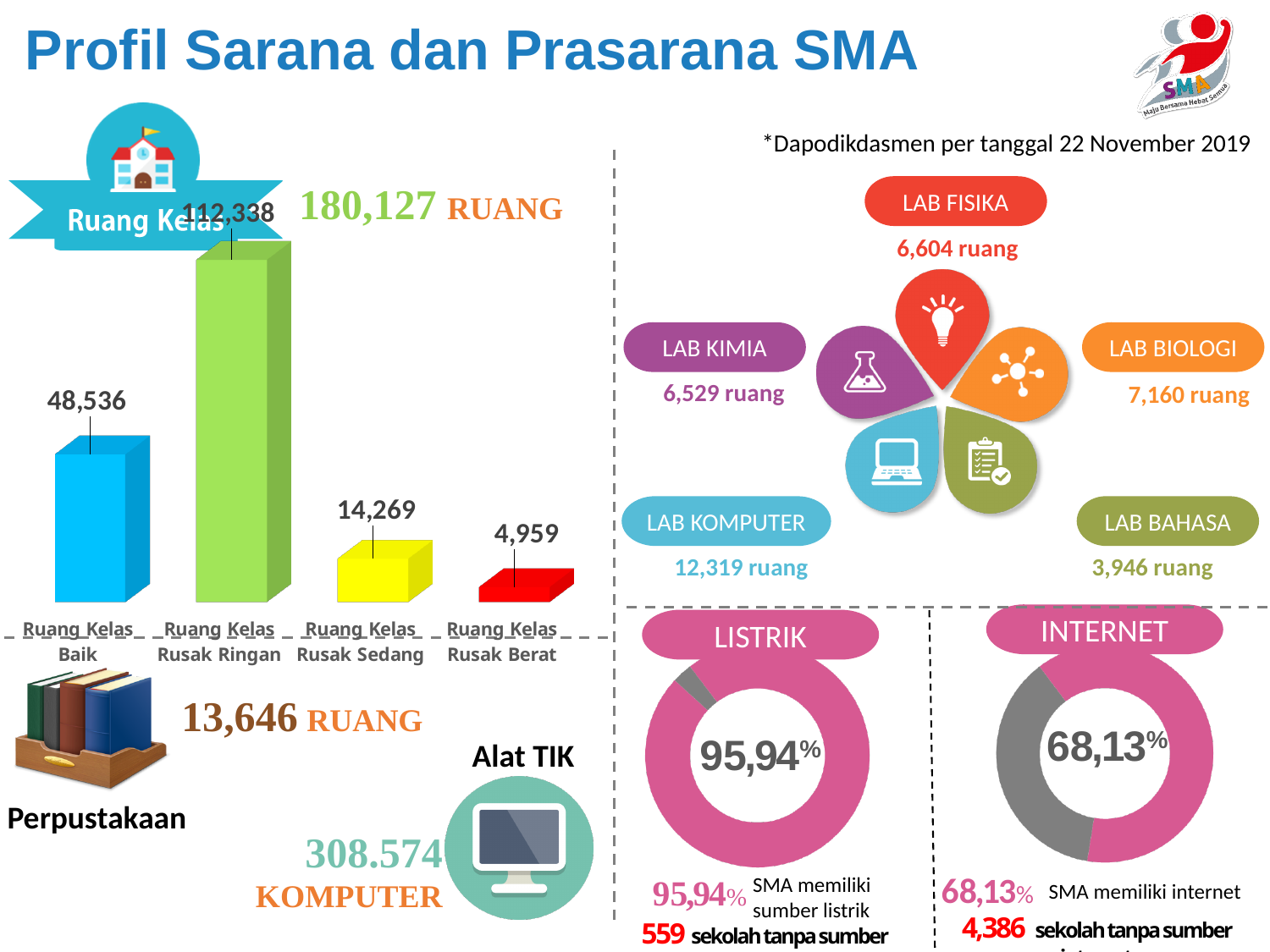
In the Ruang Kelas bar chart, what is the difference between Ruang Kelas Rusak Ringan and Ruang Kelas Baik? 63,802 In the Ruang Kelas bar chart, which category has the highest value? Ruang Kelas Rusak Ringan In the Ruang Kelas bar chart, what is the value for Ruang Kelas Rusak Berat? 4,959 In the Ruang Kelas bar chart, which category has the lowest value? Ruang Kelas Rusak Berat In the LISTRIK donut chart, what percentage is shown in the centre? 95,94% What kind of chart is the Ruang Kelas chart on the left of the slide? Bar chart In the Ruang Kelas bar chart, what is the value for Ruang Kelas Rusak Sedang? 14,269 In the INTERNET donut chart, what percentage is shown in the centre? 68,13% In the Ruang Kelas bar chart, what is the value for Ruang Kelas Rusak Ringan? 112,338 In the Ruang Kelas bar chart, which is larger: Ruang Kelas Rusak Sedang or Ruang Kelas Rusak Berat? Ruang Kelas Rusak Sedang In the Ruang Kelas bar chart, what is the value for Ruang Kelas Baik? 48,536 How many categories does the Ruang Kelas bar chart show? 4